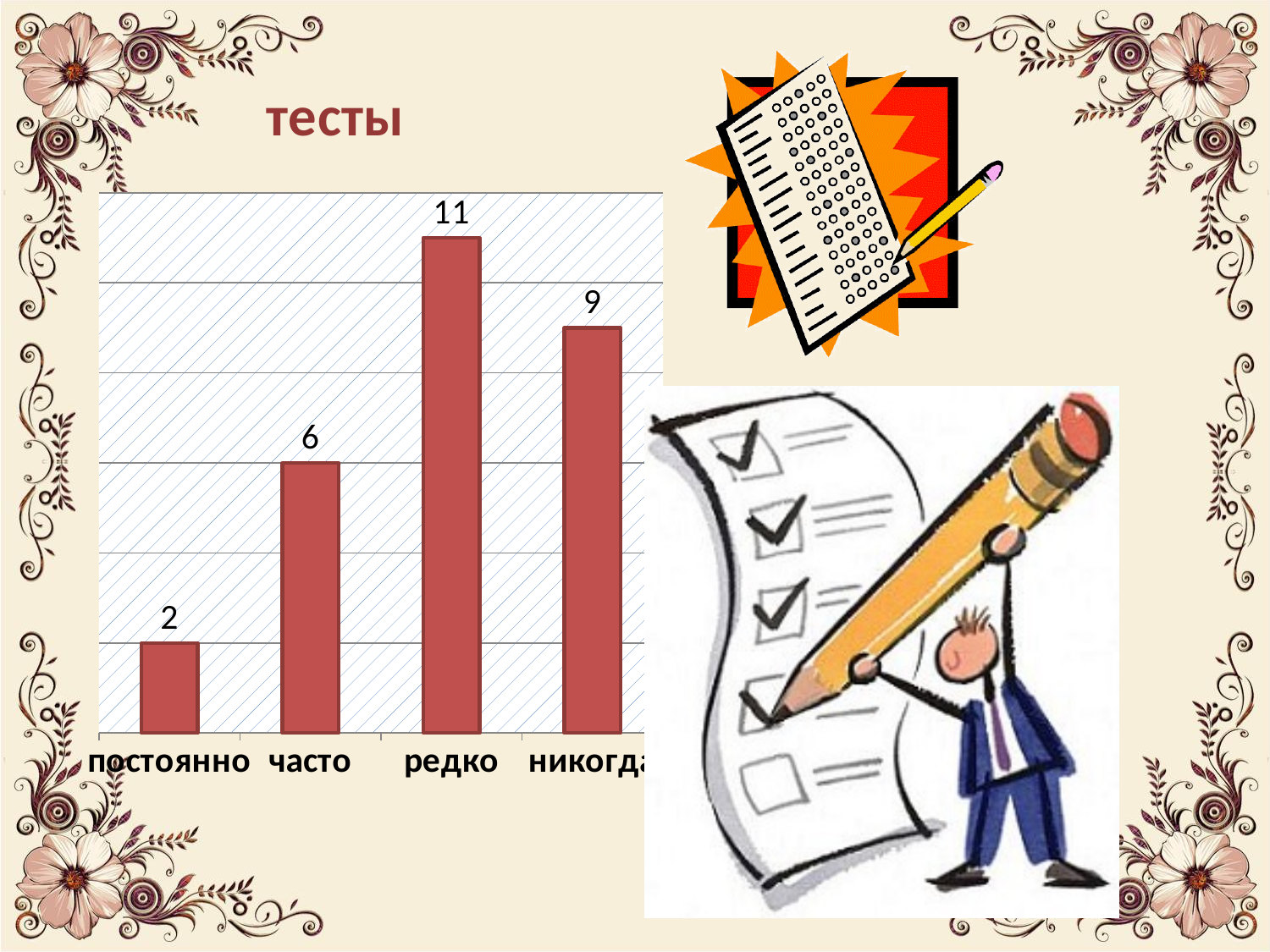
What is the value for никогда? 9 What kind of chart is shown on the slide? bar chart Which is larger, the value for часто or the value for никогда? никогда Which category has the highest value? редко What is the title of the chart? тесты How many categories are shown on the chart? 4 What is the value for редко? 11 What is the value for часто? 6 What is the value for постоянно? 2 Which category has the lowest value? постоянно What is the difference between the values for часто and постоянно? 4 What is the difference between the values for редко and никогда? 2